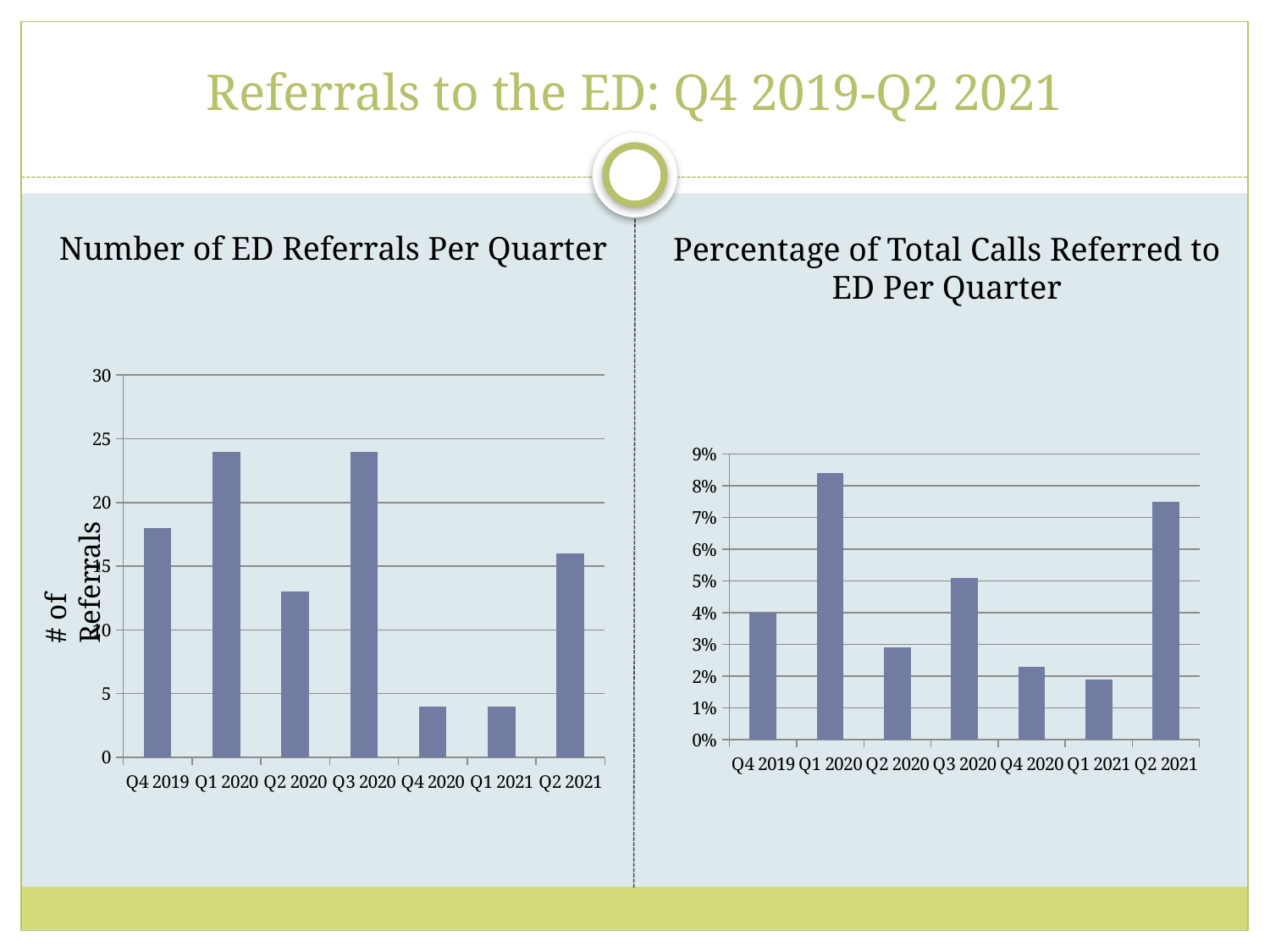
How many quarters are shown on the "Percentage of Total Calls Referred to ED Per Quarter" chart? 7 What is the y-axis label on the "Number of ED Referrals Per Quarter" chart? # of Referrals In the "Number of ED Referrals Per Quarter" chart, is the value for Q4 2020 greater or less than 5? less In the "Number of ED Referrals Per Quarter" chart, is the value for Q4 2019 greater or less than 15? greater In the "Percentage of Total Calls Referred to ED Per Quarter" chart, is the value for Q2 2021 greater or less than 7%? greater What kind of chart is the "Number of ED Referrals Per Quarter" chart? bar chart How many quarters are shown on the "Number of ED Referrals Per Quarter" chart? 7 In the "Percentage of Total Calls Referred to ED Per Quarter" chart, which quarter has the highest value? Q1 2020 In the "Number of ED Referrals Per Quarter" chart, which is larger, Q2 2020 or Q2 2021? Q2 2021 In the "Percentage of Total Calls Referred to ED Per Quarter" chart, which is larger, Q3 2020 or Q2 2020? Q3 2020